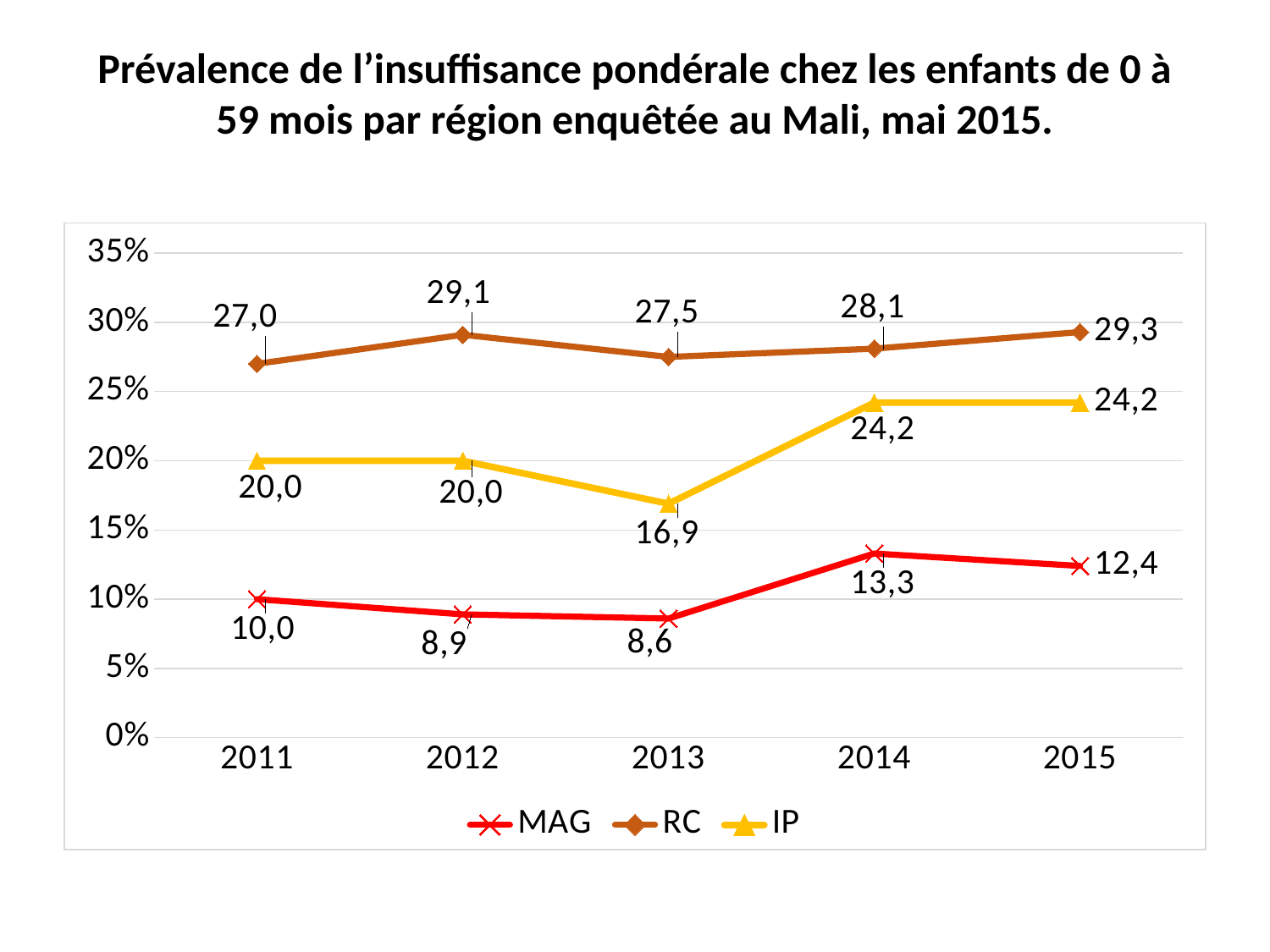
How many series does the legend list? 3 What is the value for IP in 2013? 16,9 How many years are plotted along the x axis? 5 What is the value for RC in 2012? 29,1 Which series is drawn in yellow with triangle markers? IP What is the difference between the IP values in 2014 and 2013? 7,3 What is the value for MAG in 2014? 13,3 Which series has the larger value in 2011, RC or IP? RC In which year is the RC series at its highest? 2015 What type of chart is shown on the slide? line chart In which year is the MAG series at its lowest? 2013 Does the MAG series rise or fall from 2013 to 2014? rise